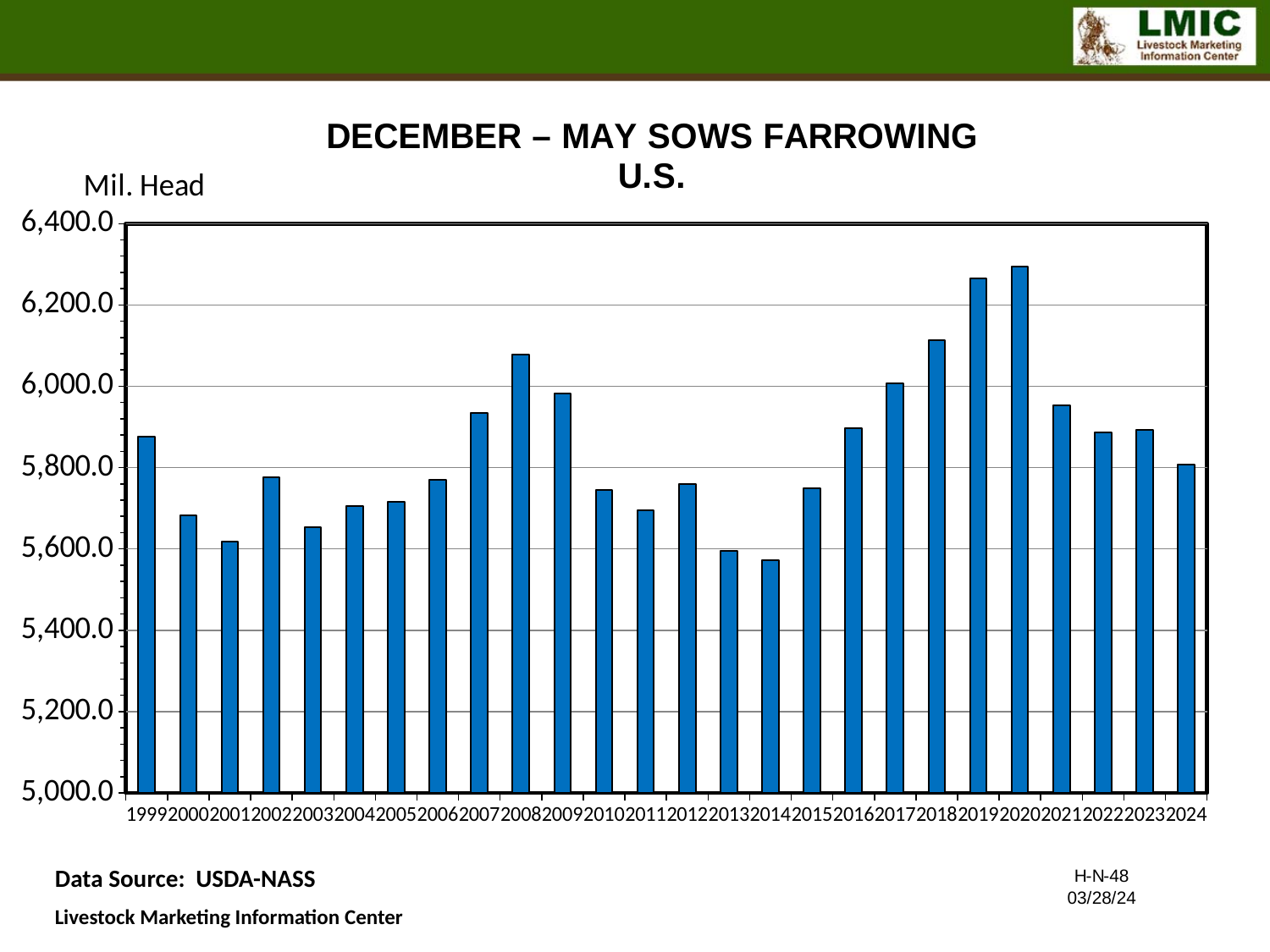
What unit is shown on the y axis of the chart? Mil. Head Which year has the lowest value for December–May sows farrowing? 2014 How many years are plotted on the x axis? 26 What kind of chart is shown on the slide? bar chart Which year has the highest value for December–May sows farrowing? 2020 Is the value for 2021 greater or less than 6,000.0? less Which year has the larger value, 2015 or 2016? 2016 Is the value for 2008 greater or less than 6,000.0? greater Is the value for 2019 greater or less than 6,200.0? greater Which year has the larger value, 2008 or 2009? 2008 Do the values generally rise or fall from 2014 to 2020? rise